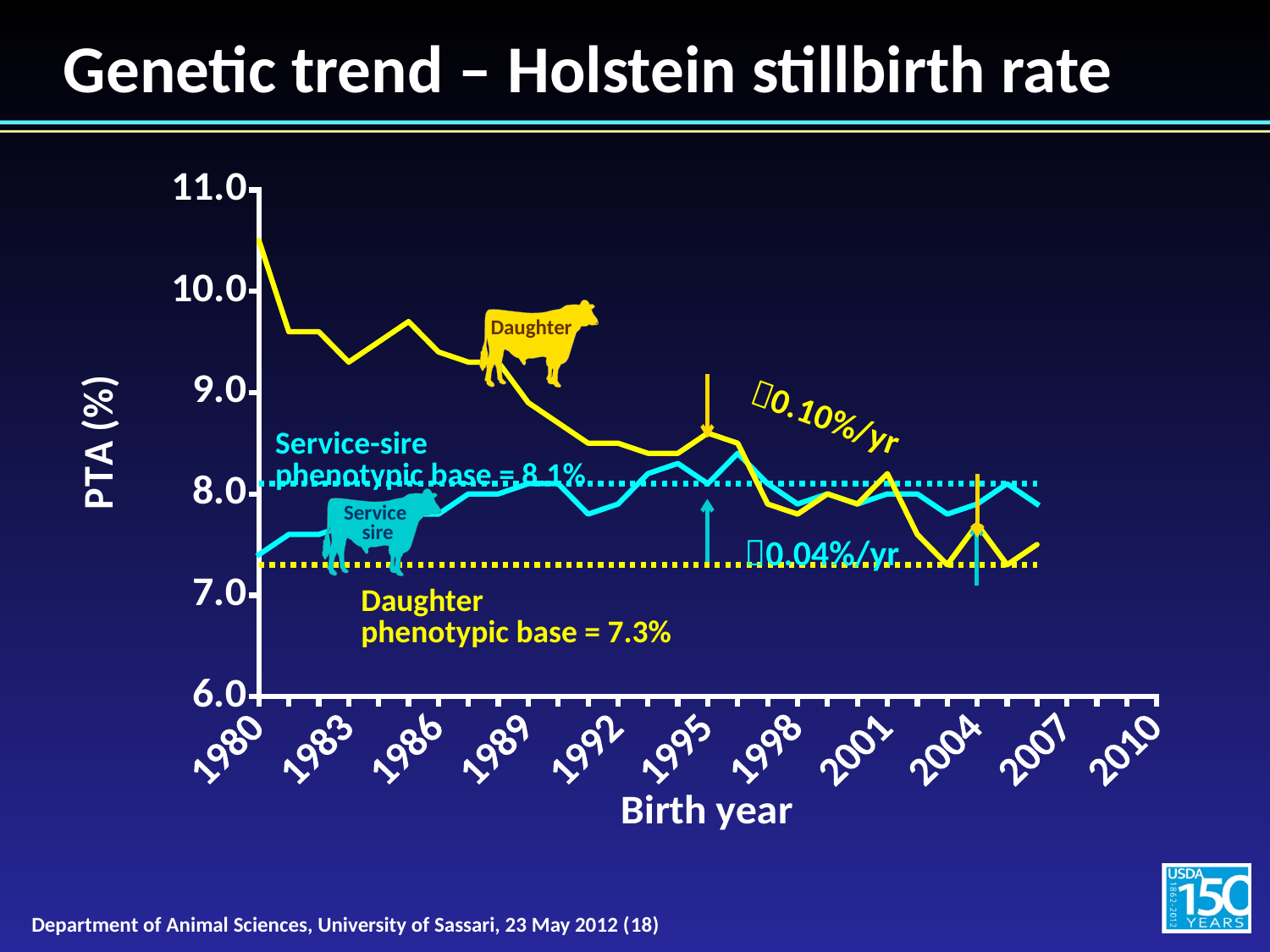
What is the Service-sire phenotypic base shown on the chart? 8.1% What is the Daughter phenotypic base shown on the chart? 7.3% What kind of chart is shown on the slide? line chart Is the Daughter PTA for birth year 1986 greater or less than 9.0? greater Is the Service sire PTA for birth year 1980 greater or less than 8.0? less What is the label of the y axis? PTA (%) In which birth year is the Daughter PTA highest? 1980 What is the title of the chart on the slide? Genetic trend – Holstein stillbirth rate Does the Daughter PTA rise or fall from 1980 to 2007? fall Is the Daughter PTA for birth year 1980 greater or less than 10.0? greater In birth year 1980, which series has the higher PTA, Daughter or Service sire? Daughter How many series are plotted in the chart? 4